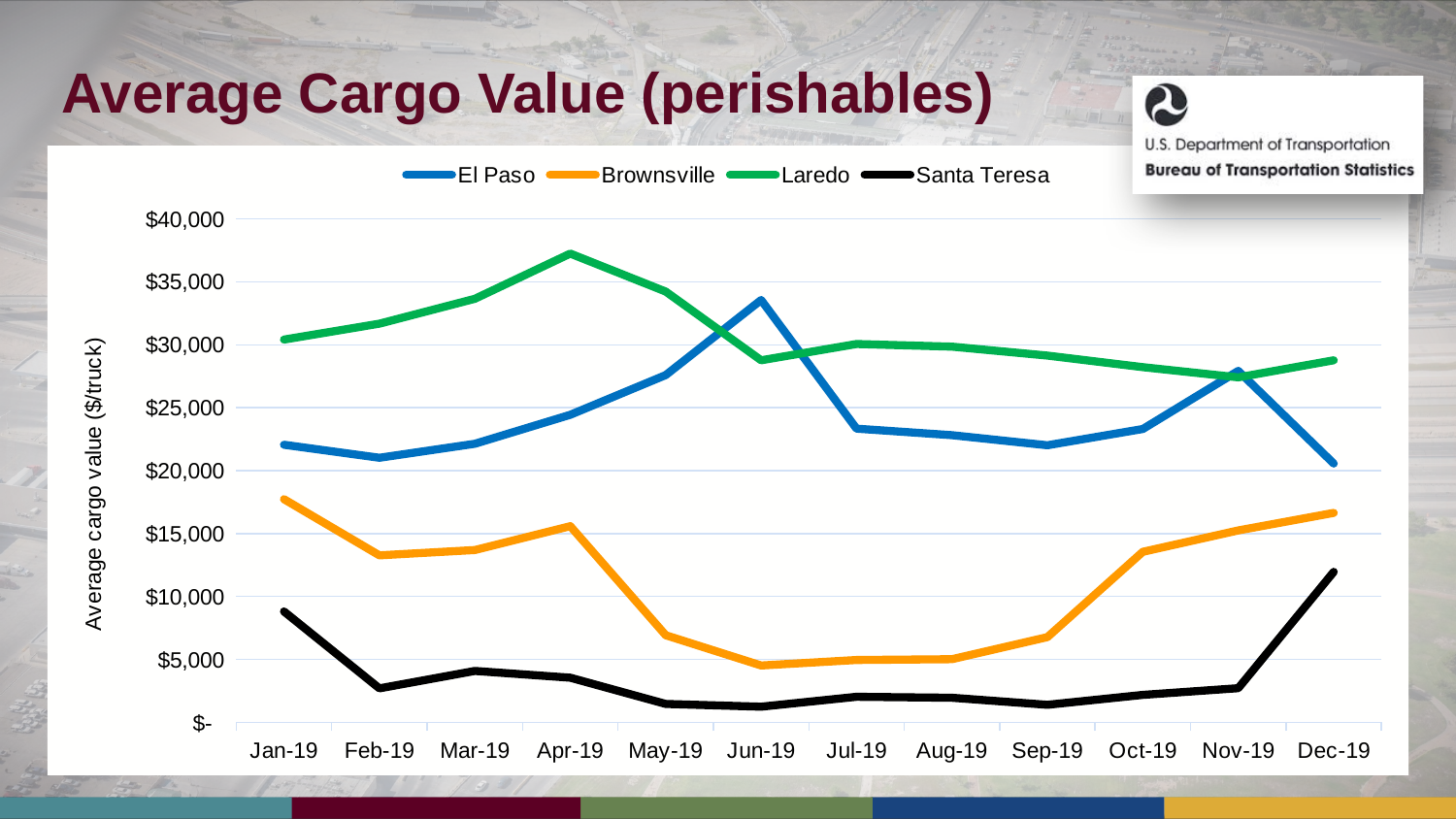
Is the value for Brownsville in May-19 greater or less than $10,000? less How many months are plotted along the x axis? 12 In which month does Santa Teresa reach its highest value? Dec-19 In which month does Laredo reach its highest value? Apr-19 Is the value for Laredo in Apr-19 greater or less than $35,000? greater What kind of chart is shown on the slide? Line chart What is the label on the y axis? Average cargo value ($/truck) In Jun-19, which is larger: the value for El Paso or the value for Laredo? El Paso Is the value for Santa Teresa in Jan-19 greater or less than $10,000? less In which month does El Paso reach its highest value? Jun-19 How many series does the legend list? 4